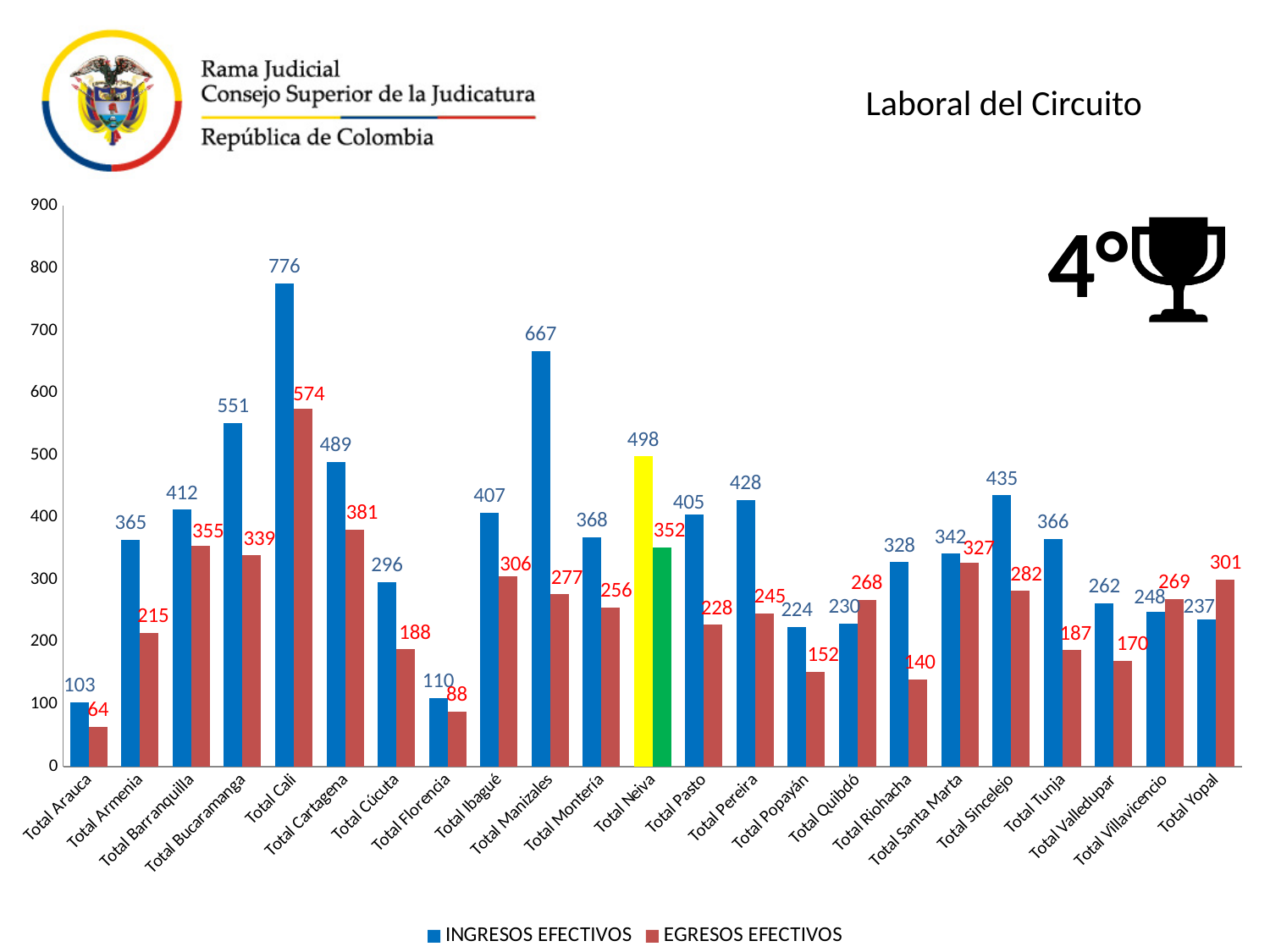
How many series does the legend list? 2 What kind of chart is shown on the slide? Bar chart Which is larger for Total Yopal: INGRESOS EFECTIVOS or EGRESOS EFECTIVOS? EGRESOS EFECTIVOS Which category has the lowest EGRESOS EFECTIVOS value? Total Arauca How many categories are shown on the x axis of the chart? 23 What is the difference between INGRESOS EFECTIVOS and EGRESOS EFECTIVOS for Total Neiva? 146 Which category has the highest INGRESOS EFECTIVOS value? Total Cali What is the INGRESOS EFECTIVOS value for Total Cali? 776 What is the INGRESOS EFECTIVOS value for Total Manizales? 667 What is the EGRESOS EFECTIVOS value for Total Neiva? 352 Which category's INGRESOS EFECTIVOS bar is highlighted in yellow? Total Neiva Is the INGRESOS EFECTIVOS value for Total Bucaramanga greater or less than 500? greater